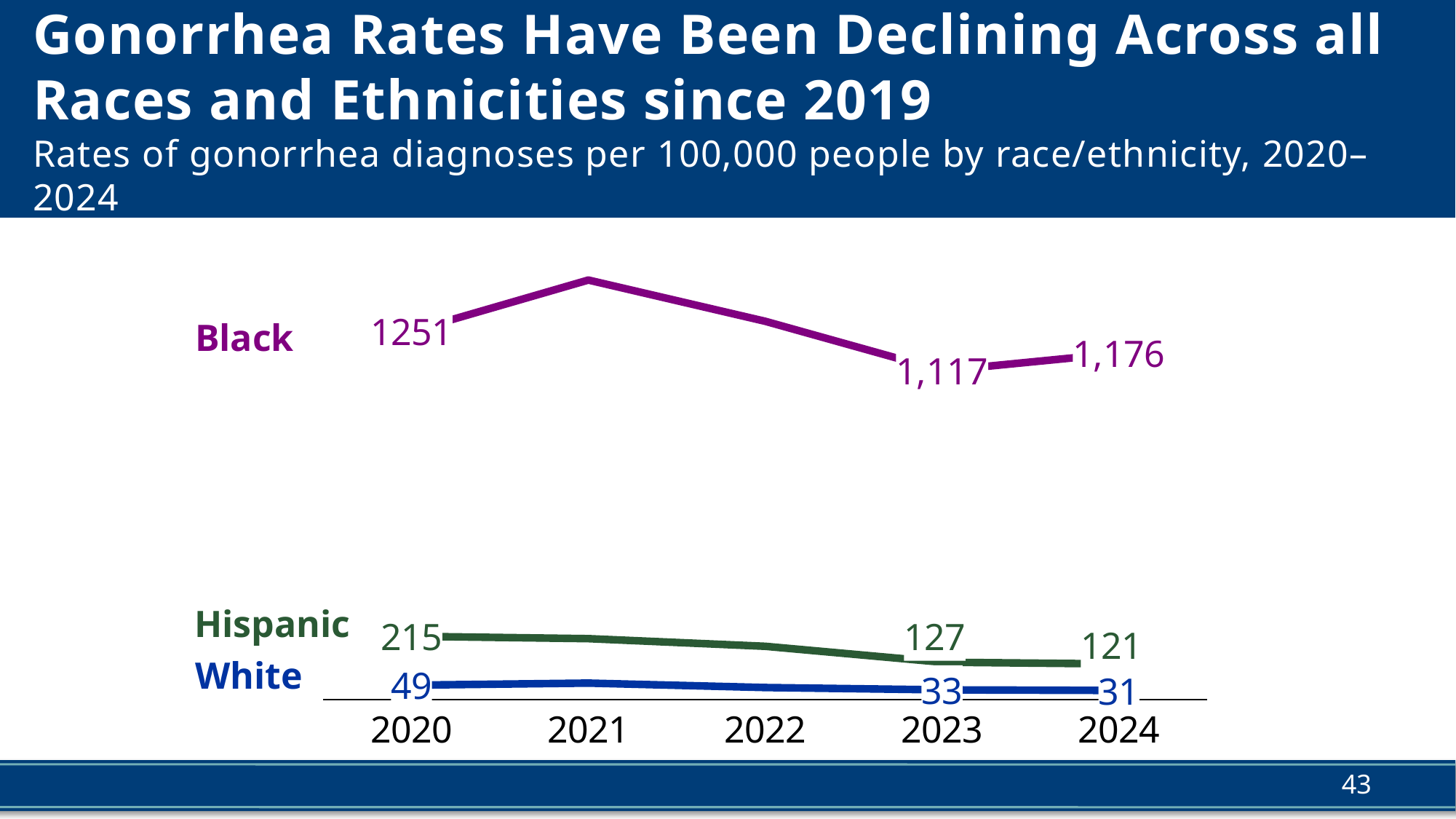
What was the gonorrhea rate for Black people in 2024? 1,176 How many race/ethnicity series are plotted on the chart? 3 What was the gonorrhea rate for Hispanic people in 2023? 127 Which race/ethnicity had the highest gonorrhea rate in 2024? Black Which race/ethnicity had the lowest gonorrhea rate in 2020? White What is the difference between the White rate in 2020 and in 2023? 16 What kind of chart is shown on the slide? Line chart How many years are shown on the x axis? 5 Was the Black rate higher in 2023 or in 2024? 2024 What is the difference between the Hispanic rate in 2020 and in 2024? 94 What was the gonorrhea rate for Black people in 2020? 1251 What was the gonorrhea rate for White people in 2024? 31